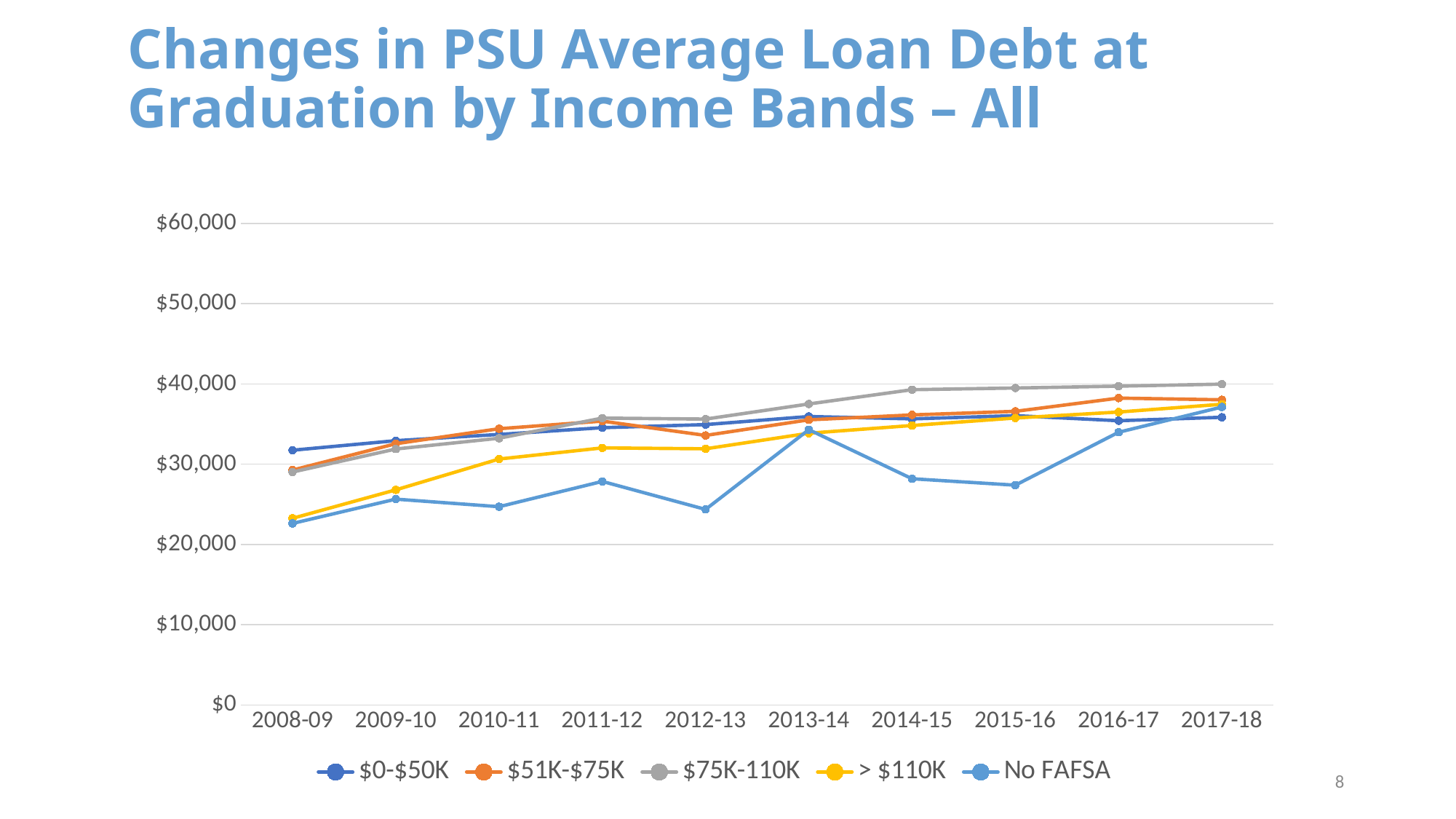
How many series does the legend list? 5 How many academic years are shown along the x axis? 10 Which series has the highest value in 2017-18? $75K-110K Is the value for > $110K in 2008-09 greater or less than $30,000? less What kind of chart is shown on the slide? line chart Is the value for $0-$50K in 2008-09 greater or less than $30,000? greater Does the $75K-110K series generally rise or fall from 2008-09 to 2017-18? rise What is the title of the slide? Changes in PSU Average Loan Debt at Graduation by Income Bands – All Is the value for No FAFSA in 2012-13 greater or less than $30,000? less Which series has the lowest value in 2012-13? No FAFSA In 2008-09, which is larger: the value for $0-$50K or the value for No FAFSA? $0-$50K